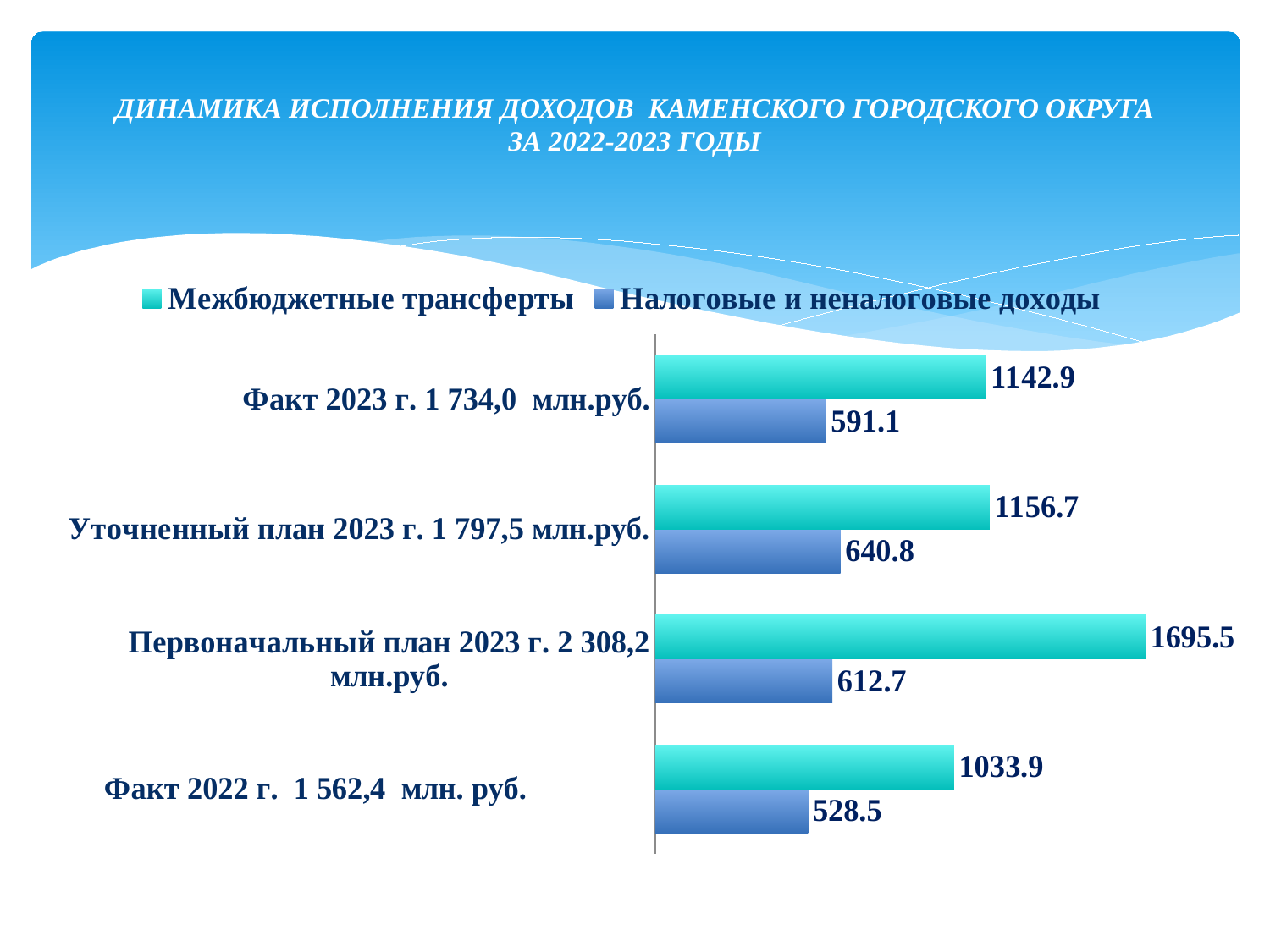
Which category has the highest value for Межбюджетные трансферты? Первоначальный план 2023 г. 2 308,2 млн.руб. Which category has the lowest value for Налоговые и неналоговые доходы? Факт 2022 г. 1 562,4 млн. руб. How many series does the legend list? 2 What is the value of Межбюджетные трансферты for Факт 2023 г.? 1142.9 What type of chart is shown on the slide? bar chart Which series is shown in teal (green-blue) colour in the legend? Межбюджетные трансферты What is the value of Налоговые и неналоговые доходы for Факт 2022 г.? 528.5 How many categories are shown on the chart? 4 What is the difference between Налоговые и неналоговые доходы for Уточненный план 2023 г. and Факт 2023 г.? 49.7 Which is larger: Налоговые и неналоговые доходы for Первоначальный план 2023 г. or for Факт 2023 г.? Первоначальный план 2023 г. What is the value of Налоговые и неналоговые доходы for Уточненный план 2023 г.? 640.8 What is the difference between Межбюджетные трансферты for Первоначальный план 2023 г. and Уточненный план 2023 г.? 538.8